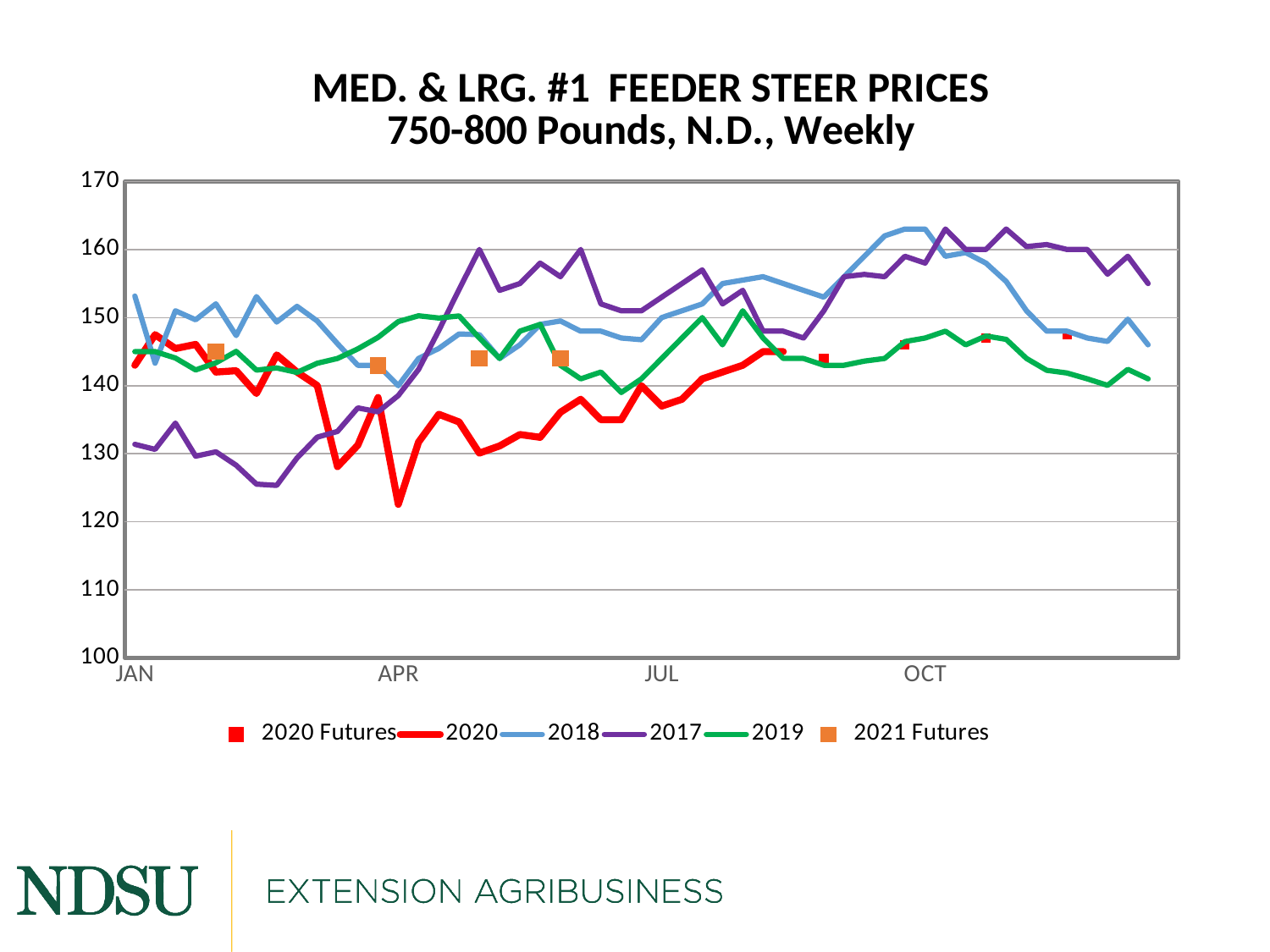
Does the 2017 series generally rise or fall from JAN to JUL? rise Is the value for 2017 at JAN greater or less than 140? less Is the lowest value of the 2020 series greater or less than 130? less At JAN, which series has the larger value, 2018 or 2017? 2018 Is the value for 2018 at JAN greater or less than 150? greater What is the title of the chart? MED. & LRG. #1 FEEDER STEER PRICES 750-800 Pounds, N.D., Weekly What colour is the 2020 line in the chart? red What kind of chart is shown on the slide? line chart Which series reaches the lowest value anywhere on the chart? 2020 How many series does the legend list? 6 At JUL, which series has the larger value, 2017 or 2020? 2017